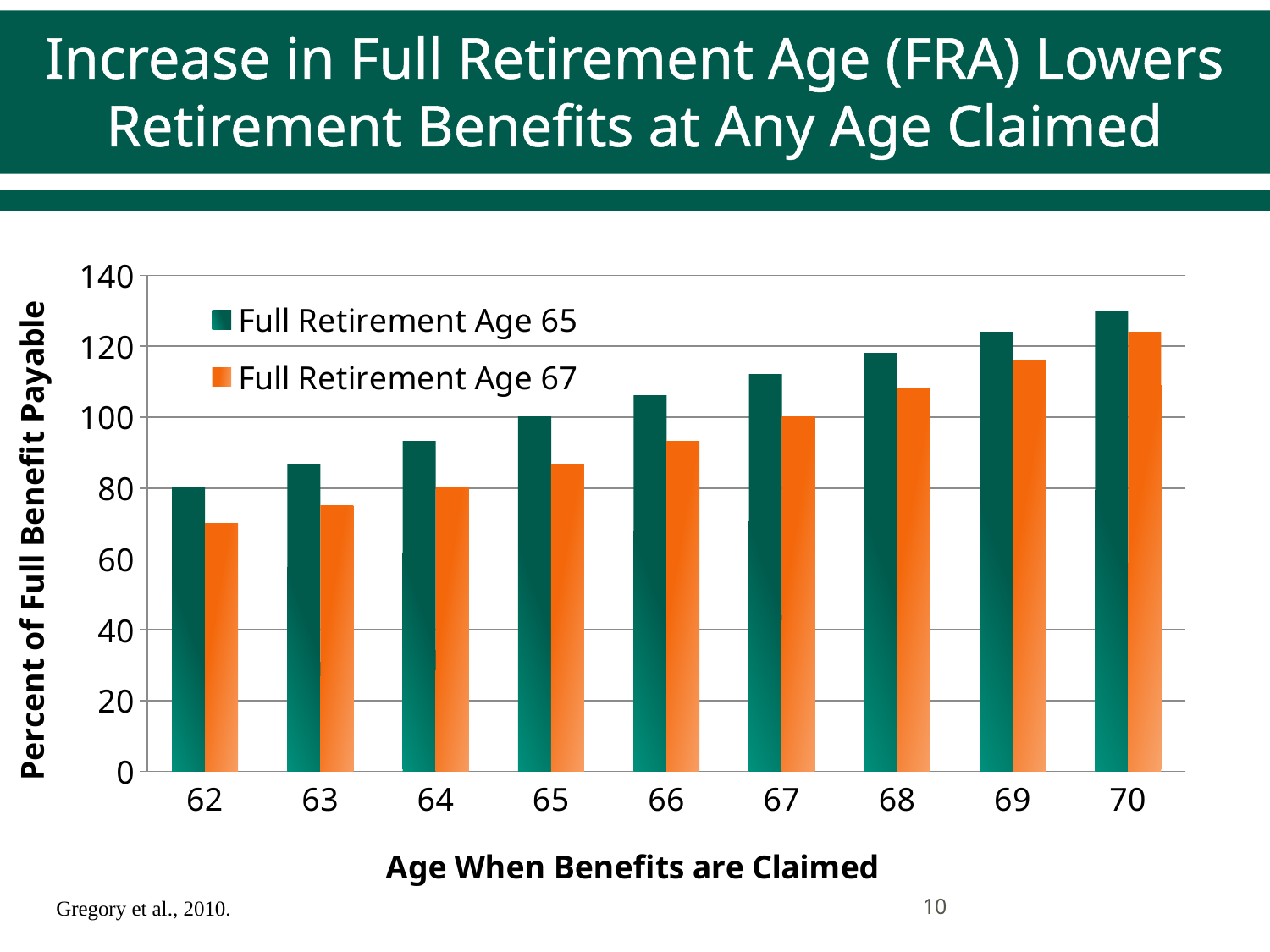
What is the value for Full Retirement Age 65 at age 65? 100 Is the value for Full Retirement Age 65 at age 70 greater or less than 120? greater At which claiming age is the Full Retirement Age 65 series highest? 70 Do the values rise or fall as the claiming age increases? rise At which claiming age is the Full Retirement Age 67 series lowest? 62 What kind of chart is shown on the slide? bar chart How many series does the legend list? 2 What is the value for Full Retirement Age 67 at age 67? 100 How many claiming ages are shown on the x axis? 9 Is the value for Full Retirement Age 67 at age 62 greater or less than 80? less What is the value for Full Retirement Age 67 at age 64? 80 What is the value for Full Retirement Age 65 at age 62? 80